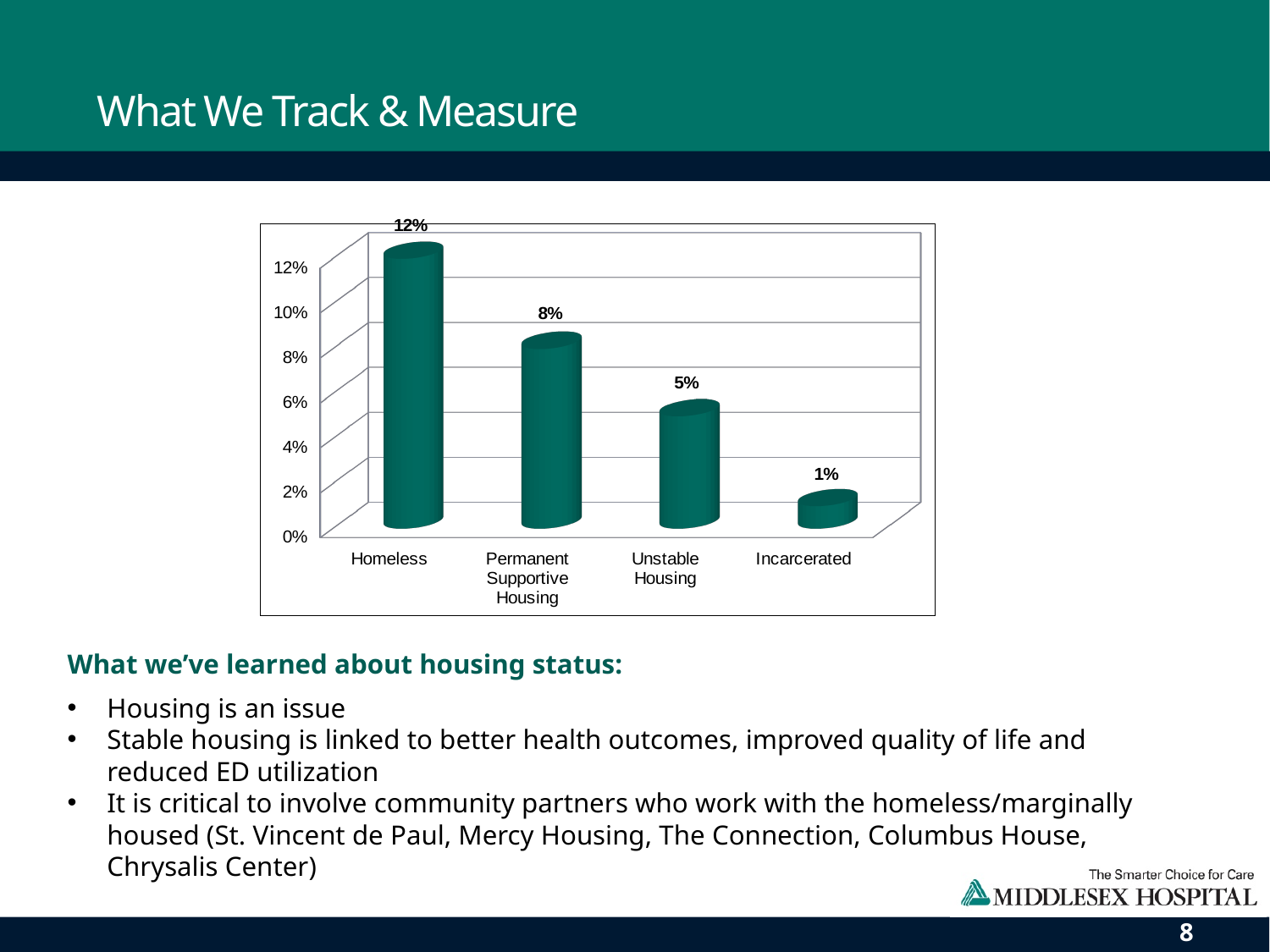
What is the value for Unstable Housing? 5% Which category has the highest value? Homeless What is the value for Permanent Supportive Housing? 8% What is the difference between the values for Homeless and Permanent Supportive Housing? 4% Which is larger, the value for Permanent Supportive Housing or the value for Unstable Housing? Permanent Supportive Housing What is the difference between the values for Unstable Housing and Incarcerated? 4% Do the values rise or fall from left to right along the x axis? Fall What is the value for Homeless? 12% What kind of chart is shown on the slide? Bar chart Which category has the lowest value? Incarcerated How many categories are shown on the x axis? 4 What is the value for Incarcerated? 1%